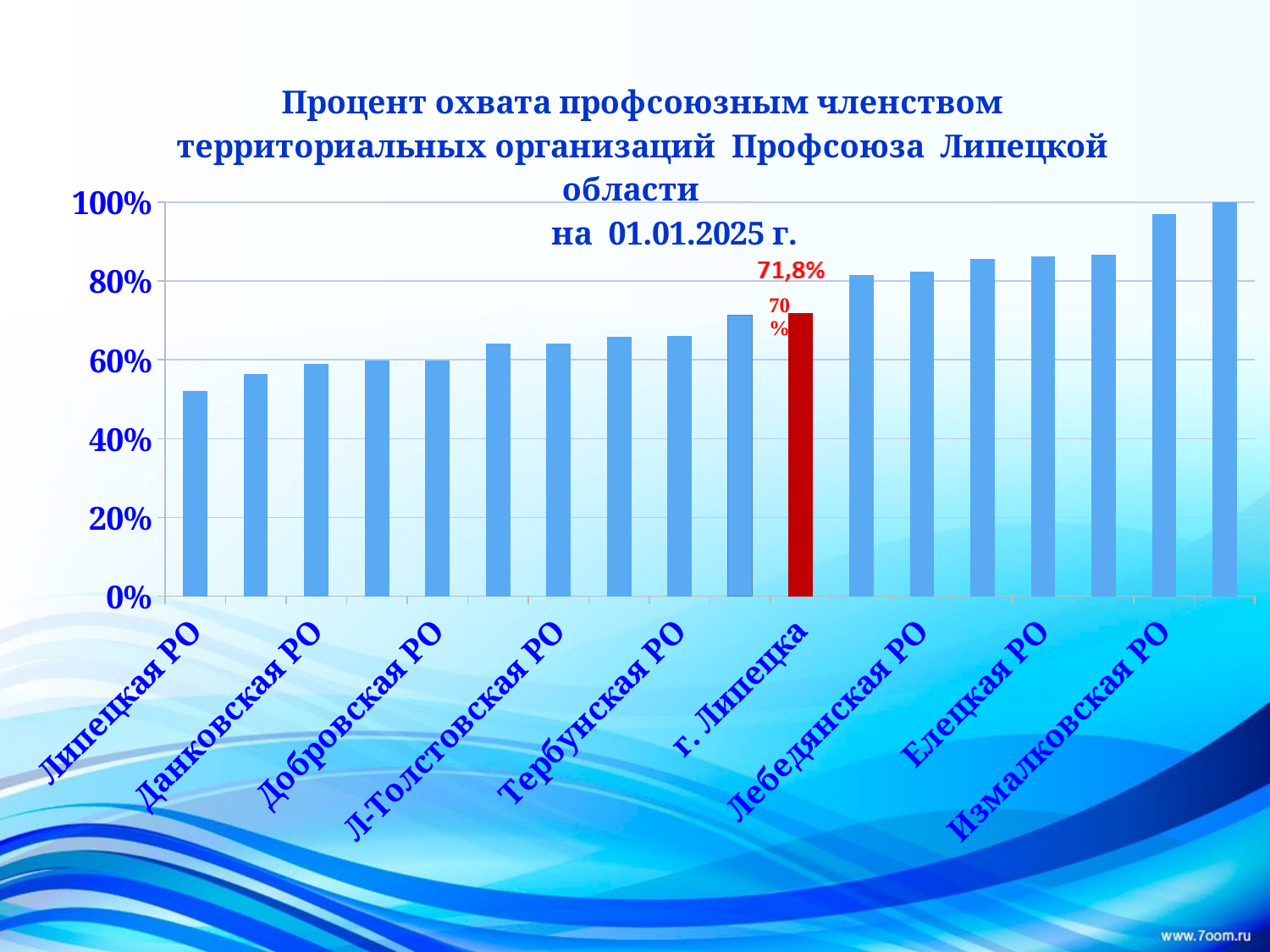
Is the value for Елецкая РО greater or less than 80%? greater How many bars are plotted in the chart? 18 What kind of chart is shown on the slide? bar chart What is the value shown for г. Липецка? 71,8% Is the value for Липецкая РО greater or less than 60%? less Which has the larger value, Измалковская РО or Липецкая РО? Измалковская РО Which has the larger value, Елецкая РО or Тербунская РО? Елецкая РО Which labelled category has the lowest value? Липецкая РО Do the values generally rise or fall from left to right along the x axis? rise Is the value for Измалковская РО greater or less than 80%? greater What colour is the bar for г. Липецка? red